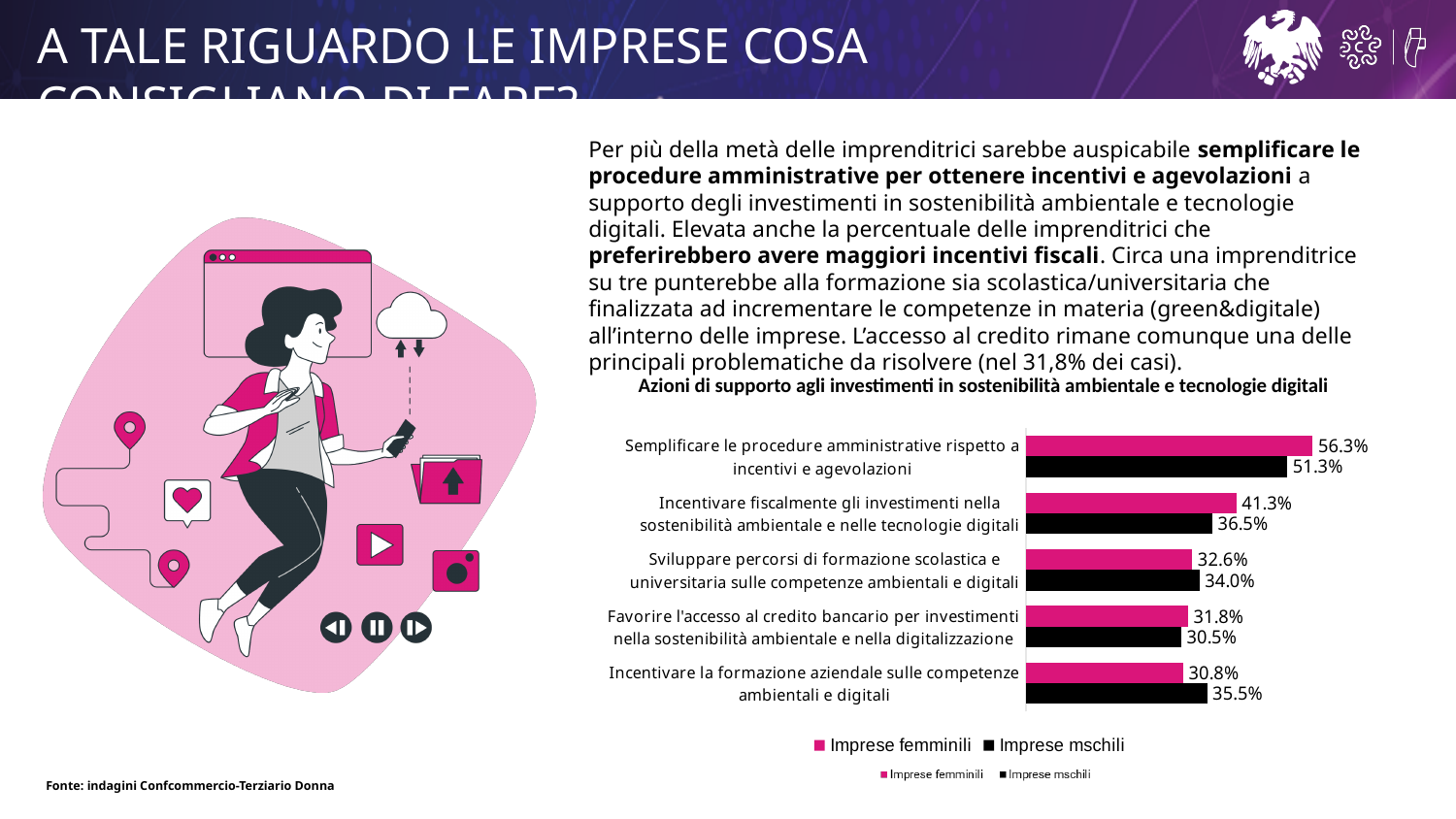
What is the value for Imprese mschili for 'Incentivare la formazione aziendale sulle competenze ambientali e digitali'? 35.5% How many categories are shown in the chart? 5 How many series does the legend list? 2 What is the value for Imprese femminili for 'Semplificare le procedure amministrative rispetto a incentivi e agevolazioni'? 56.3% Which category has the lowest value for Imprese femminili? Incentivare la formazione aziendale sulle competenze ambientali e digitali Which category has the highest value for Imprese femminili? Semplificare le procedure amministrative rispetto a incentivi e agevolazioni For 'Incentivare fiscalmente gli investimenti nella sostenibilità ambientale e nelle tecnologie digitali', which is larger: Imprese femminili or Imprese mschili? Imprese femminili What kind of chart is shown on the slide? Bar chart Which category has the lowest value for Imprese mschili? Favorire l'accesso al credito bancario per investimenti nella sostenibilità ambientale e nella digitalizzazione What is the difference between the Imprese femminili and Imprese mschili values for 'Semplificare le procedure amministrative rispetto a incentivi e agevolazioni'? 5.0% What is the difference between the Imprese mschili and Imprese femminili values for 'Incentivare la formazione aziendale sulle competenze ambientali e digitali'? 4.7% What is the value for Imprese mschili for 'Sviluppare percorsi di formazione scolastica e universitaria sulle competenze ambientali e digitali'? 34.0%